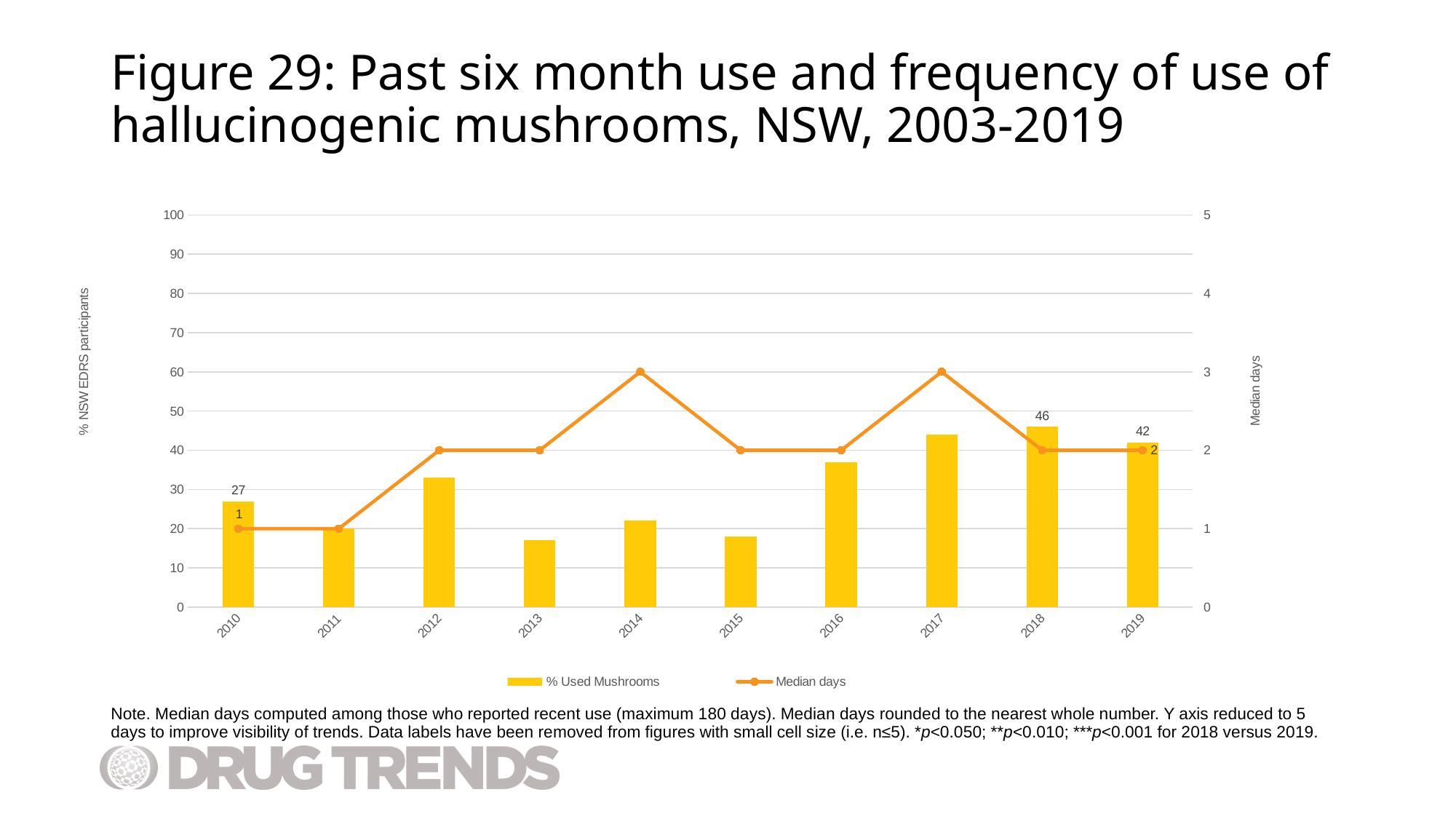
Which is larger, % Used Mushrooms in 2012 or in 2014? 2012 What is the Median days value in 2014? 3 What is the value for % Used Mushrooms in 2018? 46 What is the Median days value in 2010? 1 Is the % Used Mushrooms value for 2013 greater or less than 20? less Which year has the highest % Used Mushrooms? 2018 What is the value for % Used Mushrooms in 2010? 27 What is the difference between % Used Mushrooms in 2018 and 2019? 4 How many years are shown on the x axis? 10 What is the value for % Used Mushrooms in 2019? 42 Is the % Used Mushrooms value for 2016 greater or less than 30? greater How many series does the legend list? 2